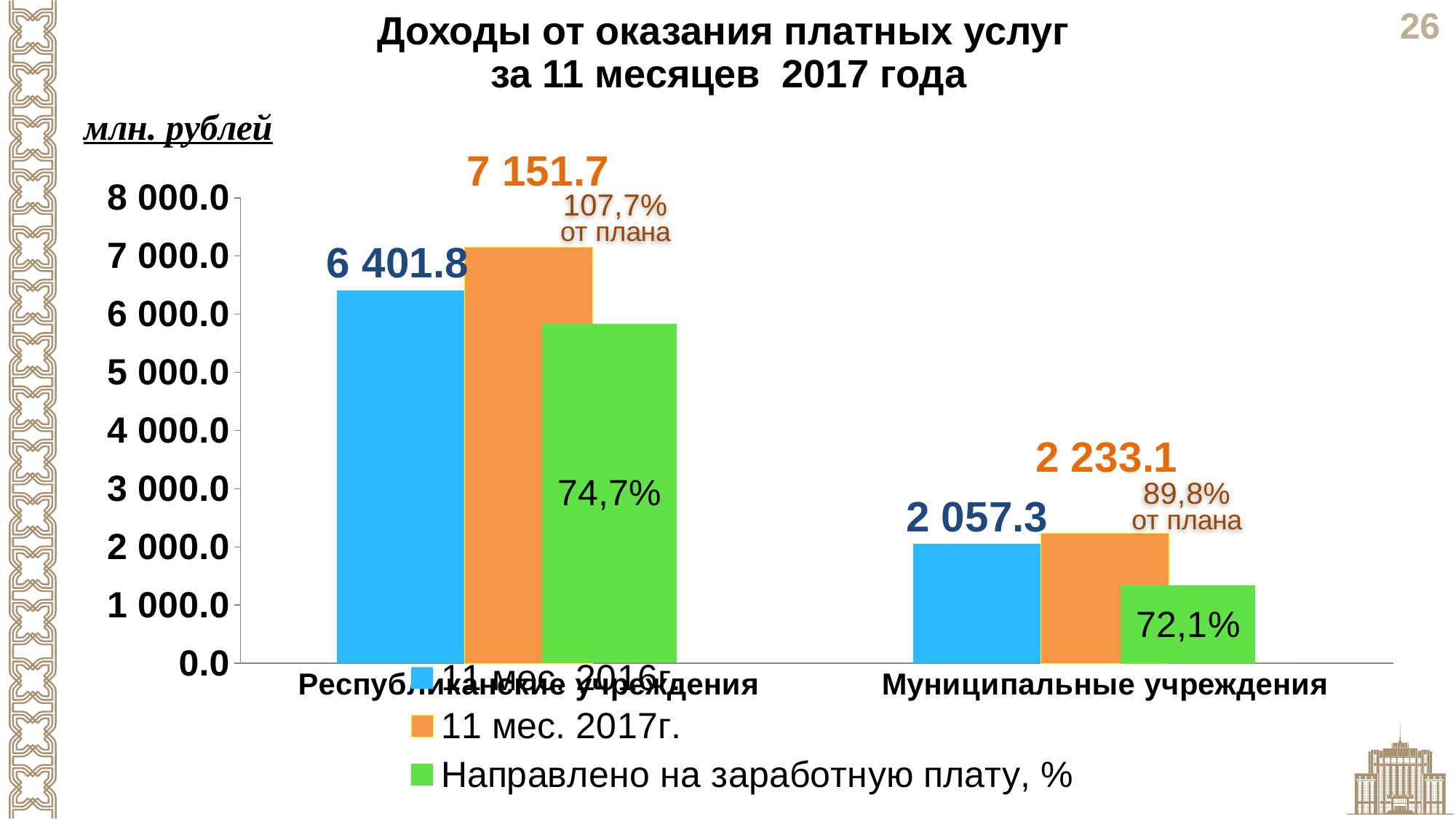
What unit is stated above the chart? млн. рублей How many categories are shown on the x axis? 2 What type of chart is shown on the slide? bar chart What is the value for "11 мес. 2016г." for Муниципальные учреждения? 2 057.3 What percentage is labelled on the green "Направлено на заработную плату, %" bar for Республиканские учреждения? 74,7% What is the difference between the "11 мес. 2017г." and "11 мес. 2016г." values for Республиканские учреждения? 749.9 How many series does the legend list? 3 What is the value for "11 мес. 2017г." for Муниципальные учреждения? 2 233.1 Is the green "Направлено на заработную плату, %" bar for Республиканские учреждения greater or less than 5 000.0 on the axis? greater Which is larger for Муниципальные учреждения: the "11 мес. 2016г." value or the "11 мес. 2017г." value? 11 мес. 2017г. What percentage of the plan is shown for Муниципальные учреждения in 11 мес. 2017г.? 89,8% What is the value for "11 мес. 2017г." for Республиканские учреждения? 7 151.7